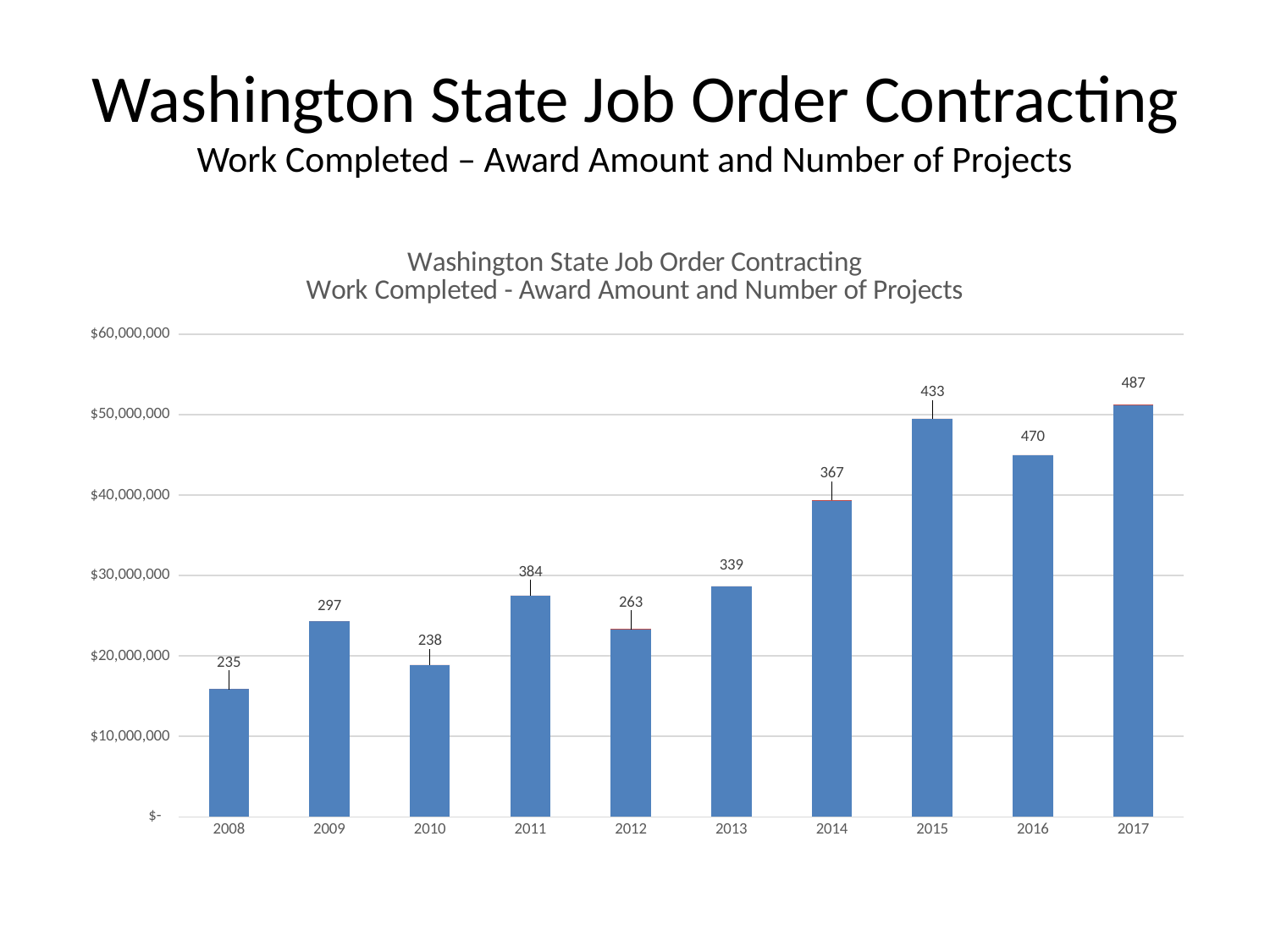
Which year has the lowest award amount bar? 2008 Which year has the larger award amount bar, 2015 or 2016? 2015 Is the award amount for 2016 greater or less than $50,000,000? less What is the number of projects labelled above the bar for 2008? 235 Is the award amount for 2008 greater or less than $20,000,000? less What is the number of projects labelled above the bar for 2012? 263 Which year has the highest award amount bar? 2017 What is the number of projects labelled above the bar for 2017? 487 What kind of chart is shown on the slide? bar chart Is the award amount for 2014 greater or less than $30,000,000? greater What is the difference between the number of projects labelled for 2017 and for 2008? 252 How many years are shown on the x axis of the chart? 10